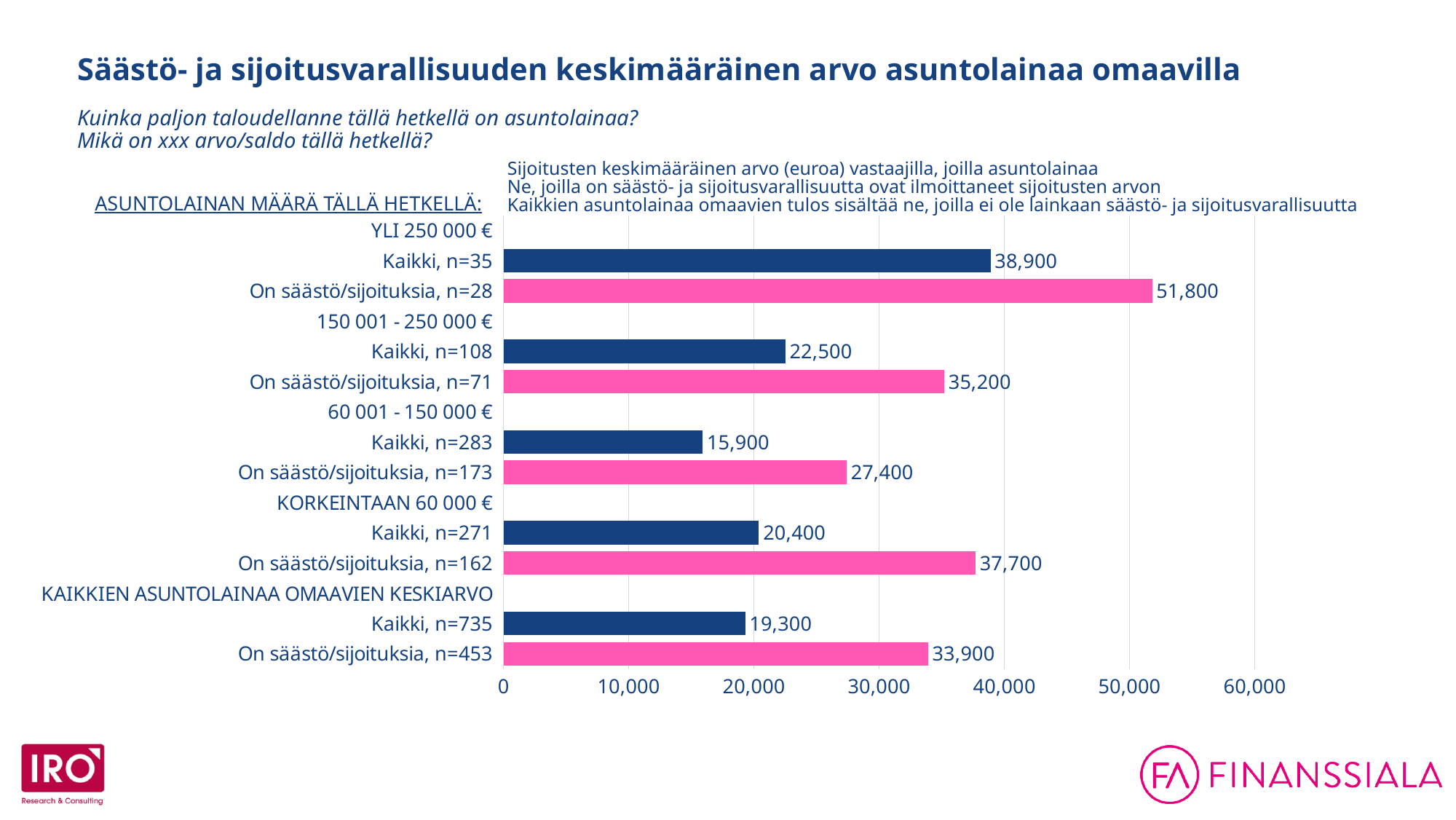
What is the value for 'On säästö/sijoituksia, n=162' in the 'KORKEINTAAN 60 000 €' group? 37,700 How many bars are plotted on the chart? 10 What type of chart is shown on the slide? Bar chart What is the average investment value for 'Kaikki, n=35' in the 'YLI 250 000 €' group? 38,900 What is the value for 'On säästö/sijoituksia, n=28' in the 'YLI 250 000 €' group? 51,800 What is the value for 'Kaikki, n=735' under 'KAIKKIEN ASUNTOLAINAA OMAAVIEN KESKIARVO'? 19,300 Is the value for 'On säästö/sijoituksia, n=173' greater or less than 30,000? less Which is larger: the value for 'Kaikki, n=271' (KORKEINTAAN 60 000 €) or 'Kaikki, n=108' (150 001 - 250 000 €)? Kaikki, n=108 Which bar has the highest value on the chart? On säästö/sijoituksia, n=28 (YLI 250 000 €) What is the difference between 'On säästö/sijoituksia, n=71' and 'Kaikki, n=108' in the '150 001 - 250 000 €' group? 12,700 Which bar has the lowest value on the chart? Kaikki, n=283 (60 001 - 150 000 €) What is the difference between 'On säästö/sijoituksia, n=453' and 'Kaikki, n=735' in the overall average group? 14,600